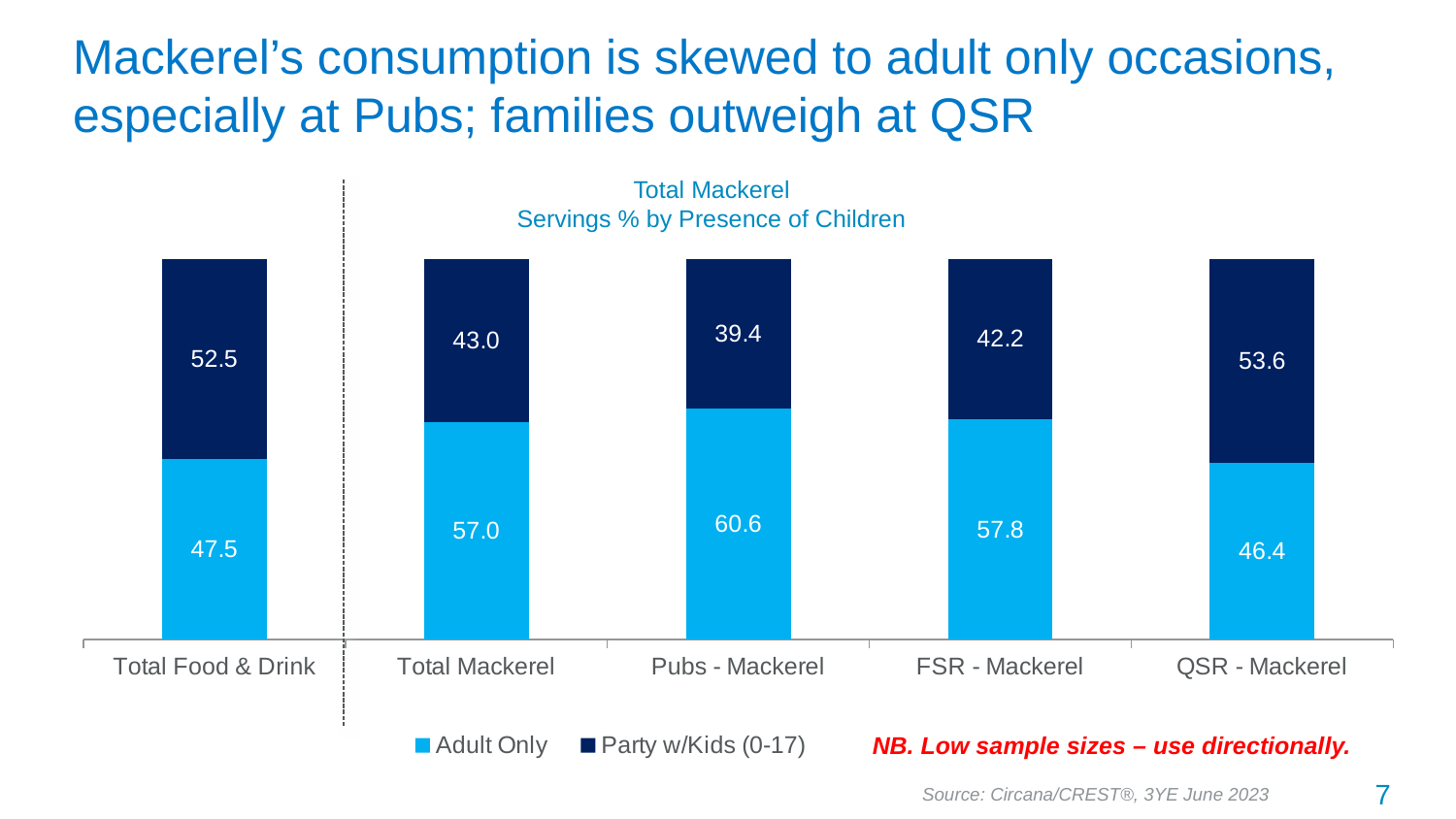
What is the Party w/Kids (0-17) value for QSR - Mackerel? 53.6 What is the Adult Only value for Pubs - Mackerel? 60.6 Which category has the lowest Party w/Kids (0-17) value? Pubs - Mackerel Which category has the highest Adult Only value? Pubs - Mackerel What kind of chart is shown on the slide? Stacked bar chart How many categories are shown on the x axis? 5 What is the Party w/Kids (0-17) value for FSR - Mackerel? 42.2 What is the Adult Only value for Total Food & Drink? 47.5 Which is larger for QSR - Mackerel: the Adult Only value or the Party w/Kids (0-17) value? Party w/Kids (0-17) What is the title of the chart? Total Mackerel Servings % by Presence of Children How many series does the legend list? 2 What is the difference between the Adult Only and Party w/Kids (0-17) values for Total Mackerel? 14.0